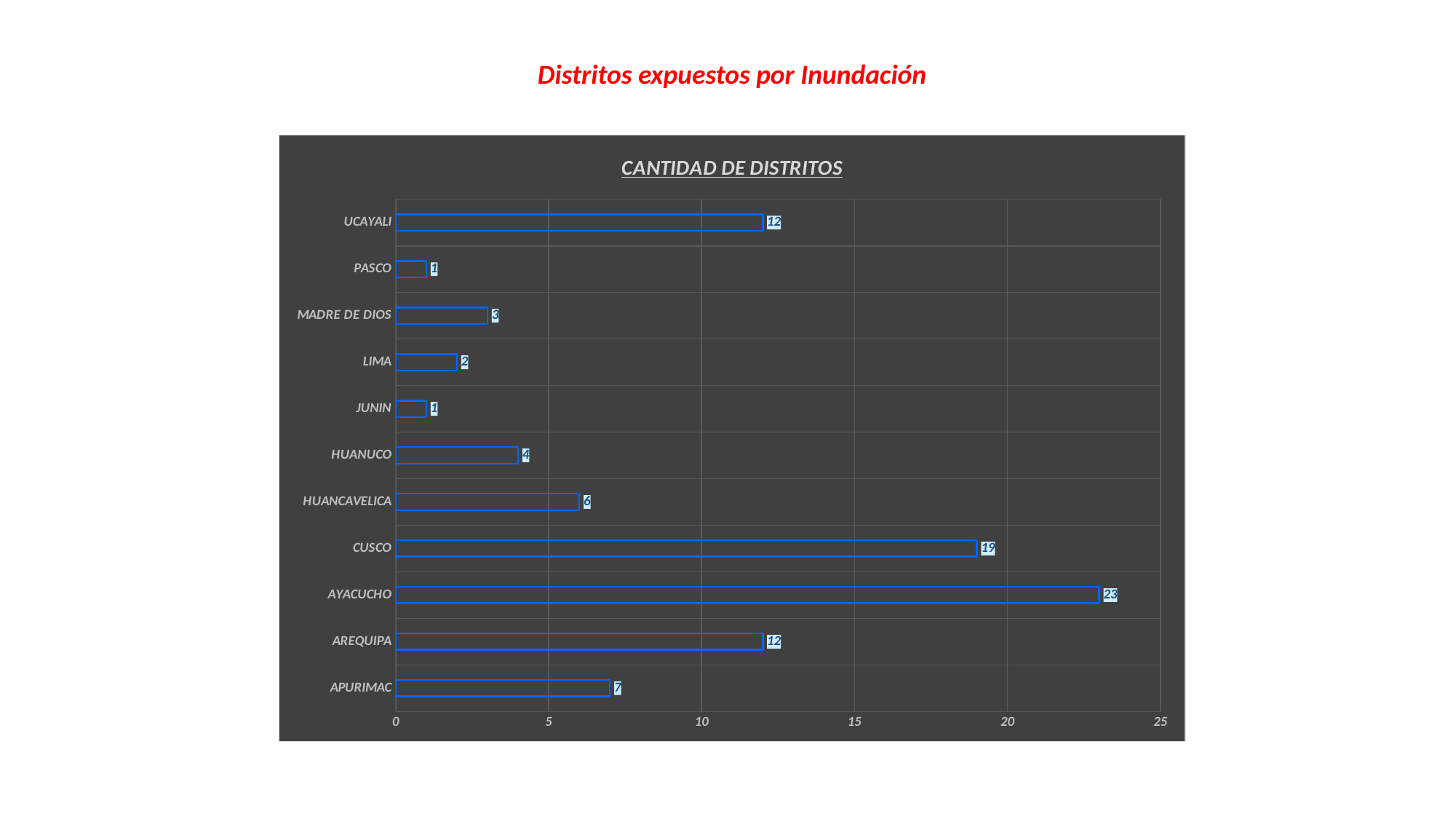
What is the value for APURIMAC? 7 What is the difference between the values for UCAYALI and PASCO? 11 Which is larger, the value for HUANUCO or the value for MADRE DE DIOS? HUANUCO Which category has the highest value? AYACUCHO What is the title of the chart? CANTIDAD DE DISTRITOS How many categories are shown in the chart? 11 Is the value for CUSCO greater or less than 15? greater What kind of chart is shown on the slide? bar chart What is the difference between the values for AYACUCHO and CUSCO? 4 What is the value for CUSCO? 19 What is the value for LIMA? 2 What is the value for HUANCAVELICA? 6